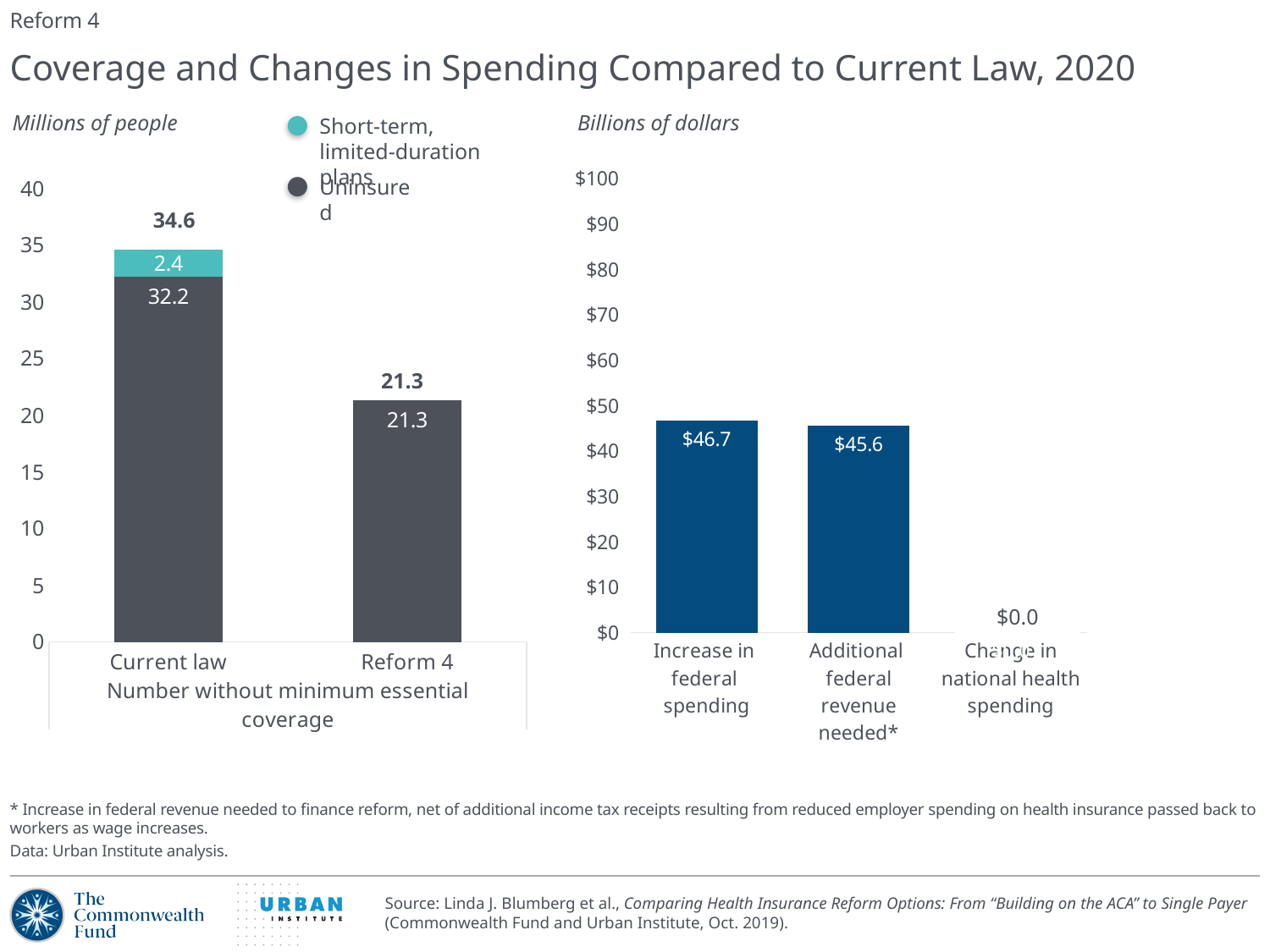
In the left chart (Millions of people), which category has the higher total, Current law or Reform 4? Current law In the right chart (Billions of dollars), what is the value for Additional federal revenue needed? $45.6 In the left chart (Millions of people), what is the difference between the Current law total and the Reform 4 total? 13.3 In the right chart (Billions of dollars), how many categories are shown on the x axis? 3 In the right chart (Billions of dollars), what is the difference between Increase in federal spending and Additional federal revenue needed? $1.1 In the left chart (Millions of people), what is the total of the Current law stacked bar? 34.6 In the right chart (Billions of dollars), what is the value for Increase in federal spending? $46.7 In the right chart (Billions of dollars), what is the value for Change in national health spending? $0.0 In the left chart (Millions of people), what is the value for Reform 4? 21.3 In the left chart (Millions of people), what is the Short-term, limited-duration plans value for Current law? 2.4 In the left chart (Millions of people), how many series does the legend list? 2 In the left chart (Millions of people), what is the Uninsured value for Current law? 32.2